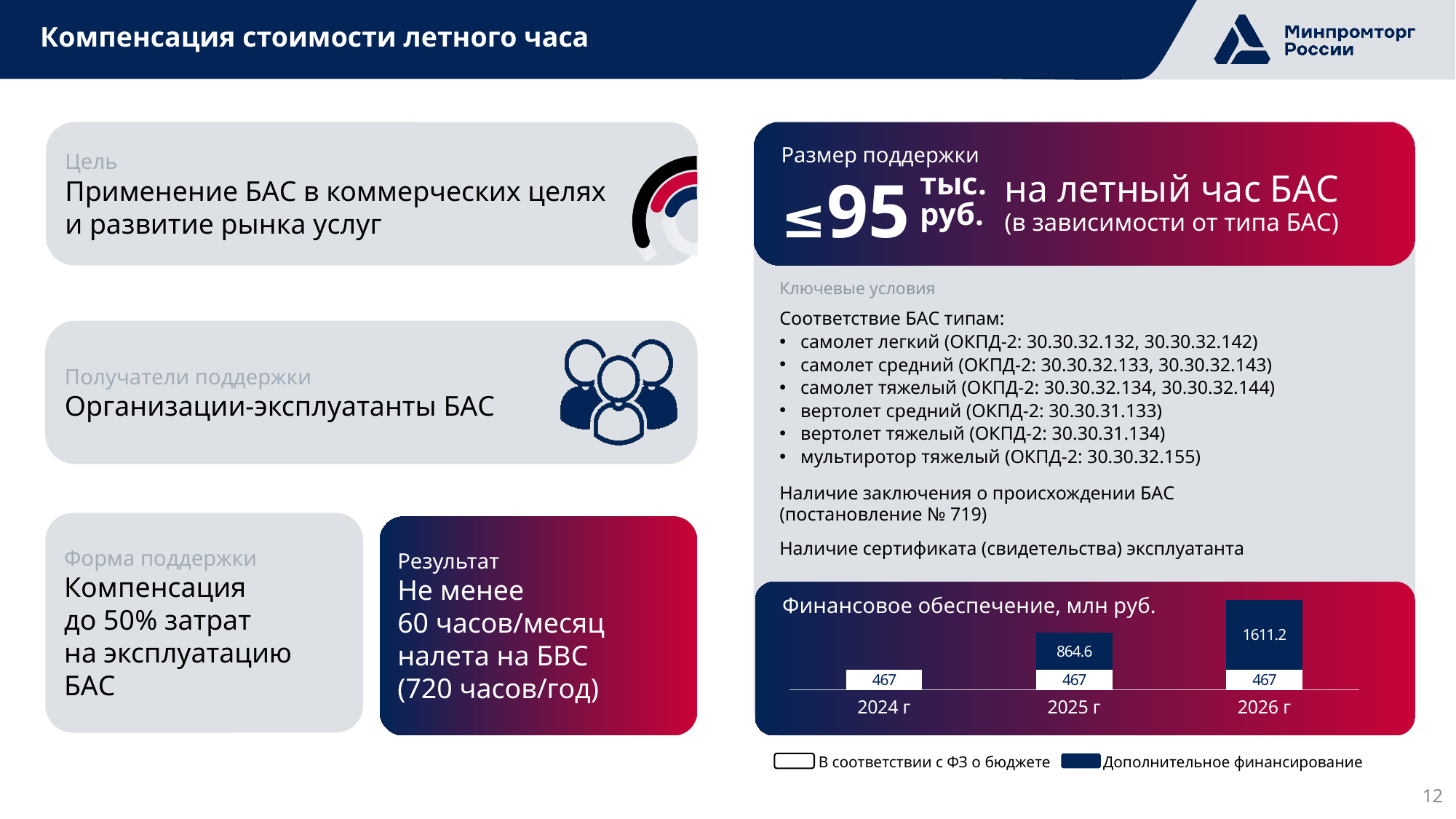
What is the difference between the 'Дополнительное финансирование' values for 2026 г and 2025 г? 746.6 Which year has the highest value for 'Дополнительное финансирование'? 2026 г What is the value of 'Дополнительное финансирование' for 2026 г? 1611.2 How many series does the chart legend list? 2 What is the value of 'Дополнительное финансирование' for 2025 г? 864.6 Which is larger: 'Дополнительное финансирование' in 2025 г or 'В соответствии с ФЗ о бюджете' in 2025 г? Дополнительное финансирование Does the total funding rise or fall from 2024 г to 2026 г? Rise How many years are shown on the x axis of the chart? 3 What is the total of the stacked bar for 2026 г? 2078.2 What type of chart is used to show 'Финансовое обеспечение, млн руб.'? Stacked bar chart What is the value of 'В соответствии с ФЗ о бюджете' for 2024 г? 467 What is the total of the stacked bar for 2025 г? 1331.6